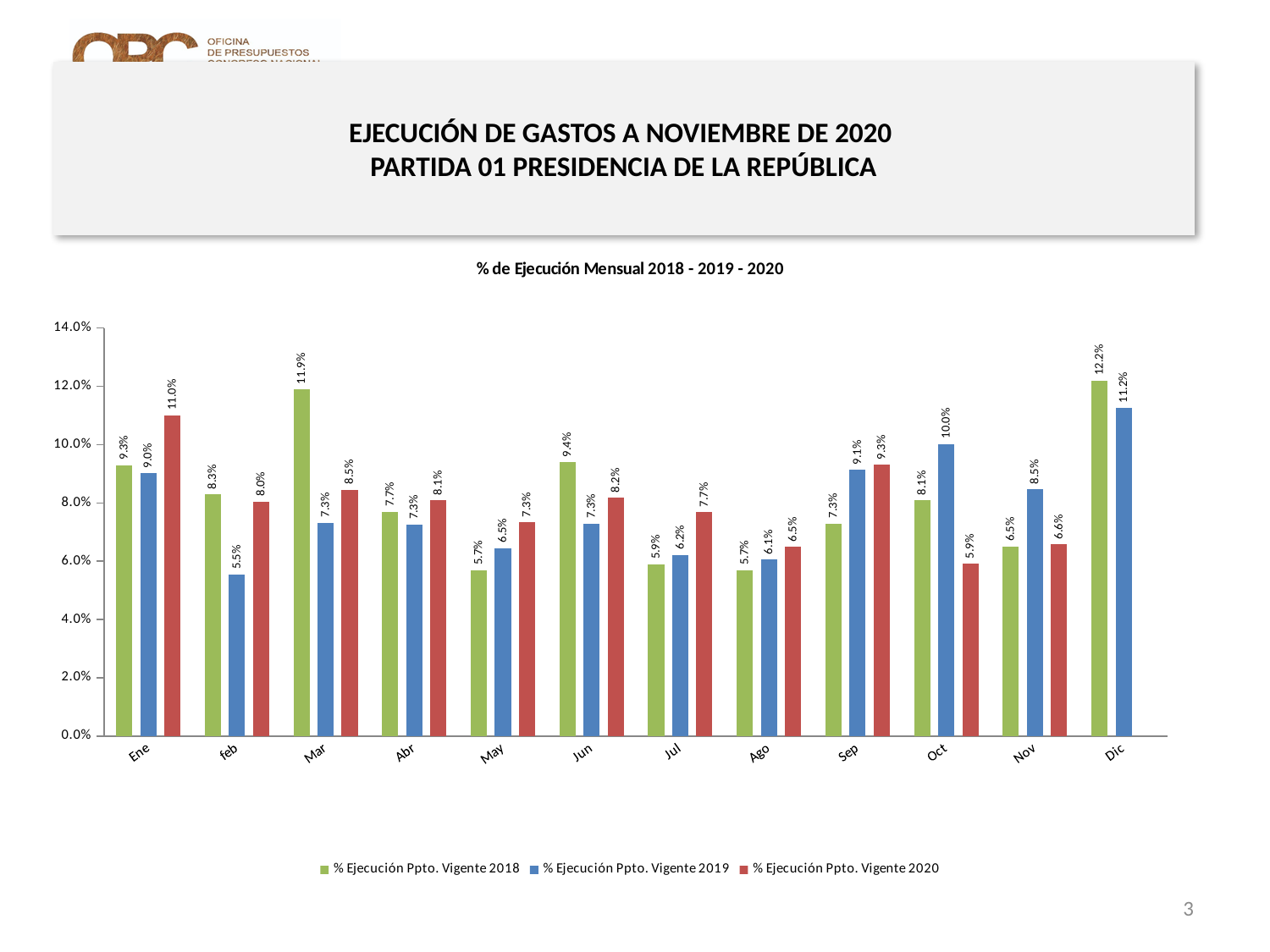
Which month has the highest % Ejecución Ppto. Vigente 2020 value? Ene What is the % Ejecución Ppto. Vigente 2019 value for Oct? 10.0% Which month has the highest % Ejecución Ppto. Vigente 2018 value? Dic What is the % Ejecución Ppto. Vigente 2020 value for Ene? 11.0% Which month has the lowest % Ejecución Ppto. Vigente 2019 value? feb For Sep, which series has the larger value: % Ejecución Ppto. Vigente 2018 or 2019? % Ejecución Ppto. Vigente 2019 What is the difference between the 2019 and 2020 values for Oct? 4.1 percentage points How many series does the legend list? 3 What is the difference between the 2018 and 2019 values for Dic? 1.0 percentage points What type of chart is shown on the slide? Bar chart What is the % Ejecución Ppto. Vigente 2018 value for Mar? 11.9% How many months are shown on the x axis? 12